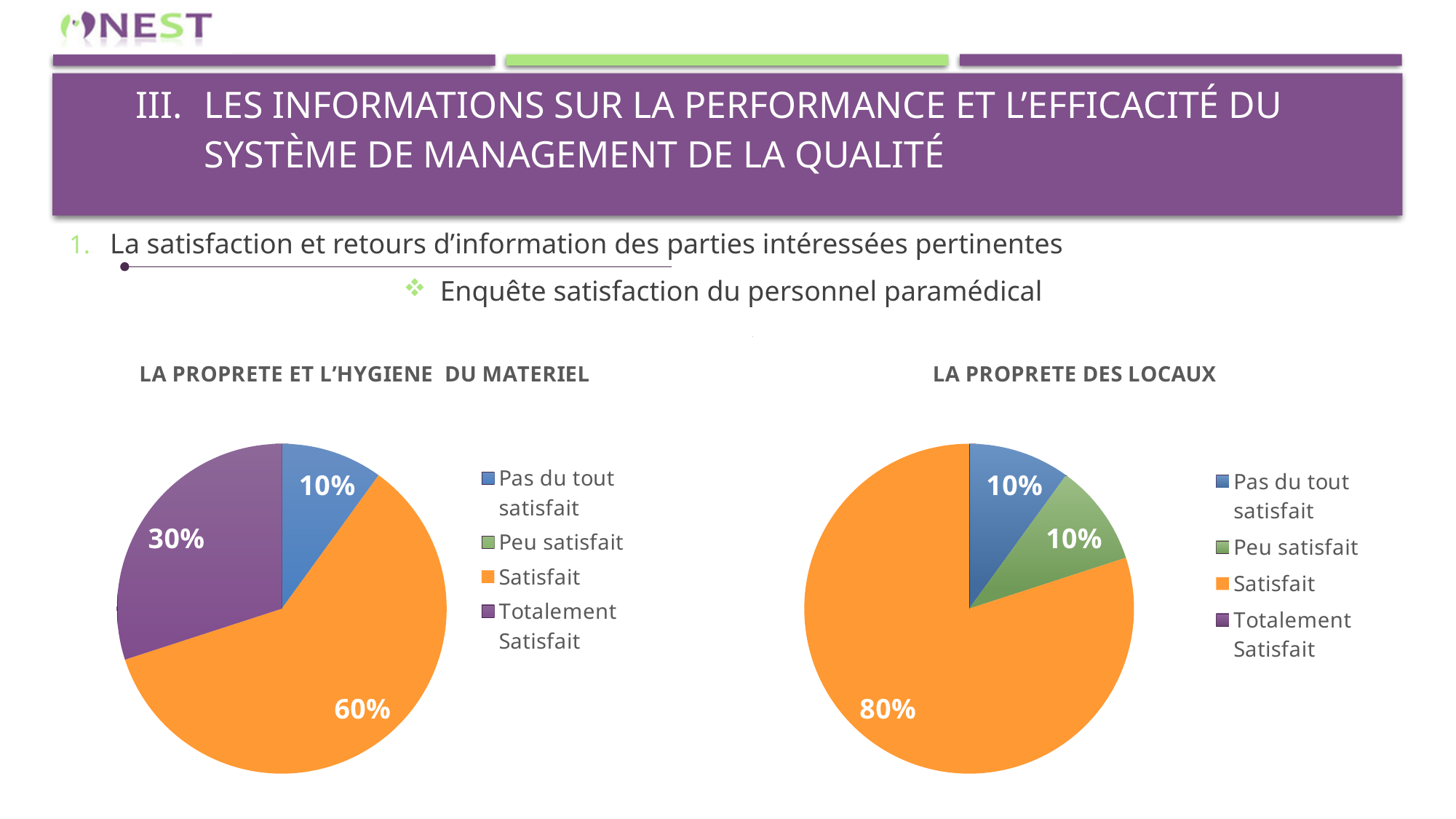
In the chart titled 'LA PROPRETE DES LOCAUX', what is the difference between the 'Satisfait' and 'Pas du tout satisfait' shares? 70% Which is larger: the 'Satisfait' share in 'LA PROPRETE DES LOCAUX' or the 'Satisfait' share in 'LA PROPRETE ET L'HYGIENE DU MATERIEL'? LA PROPRETE DES LOCAUX In the chart titled 'LA PROPRETE DES LOCAUX', what share of respondents are 'Peu satisfait'? 10% In the chart titled 'LA PROPRETE ET L'HYGIENE DU MATERIEL', what is the difference between the 'Satisfait' and 'Totalement Satisfait' shares? 30% How many entries does the legend of the chart titled 'LA PROPRETE ET L'HYGIENE DU MATERIEL' list? 4 In the chart titled 'LA PROPRETE ET L'HYGIENE DU MATERIEL', which category has the largest slice? Satisfait What type of chart is used for 'LA PROPRETE DES LOCAUX'? Pie chart In the chart titled 'LA PROPRETE ET L'HYGIENE DU MATERIEL', what share of respondents are 'Pas du tout satisfait'? 10% In the chart titled 'LA PROPRETE ET L'HYGIENE DU MATERIEL', what share of respondents are 'Totalement Satisfait'? 30% In the chart titled 'LA PROPRETE DES LOCAUX', which category has the largest slice? Satisfait In the chart titled 'LA PROPRETE DES LOCAUX', what share of respondents are 'Satisfait'? 80% In the chart titled 'LA PROPRETE ET L'HYGIENE DU MATERIEL', what share of respondents are 'Satisfait'? 60%